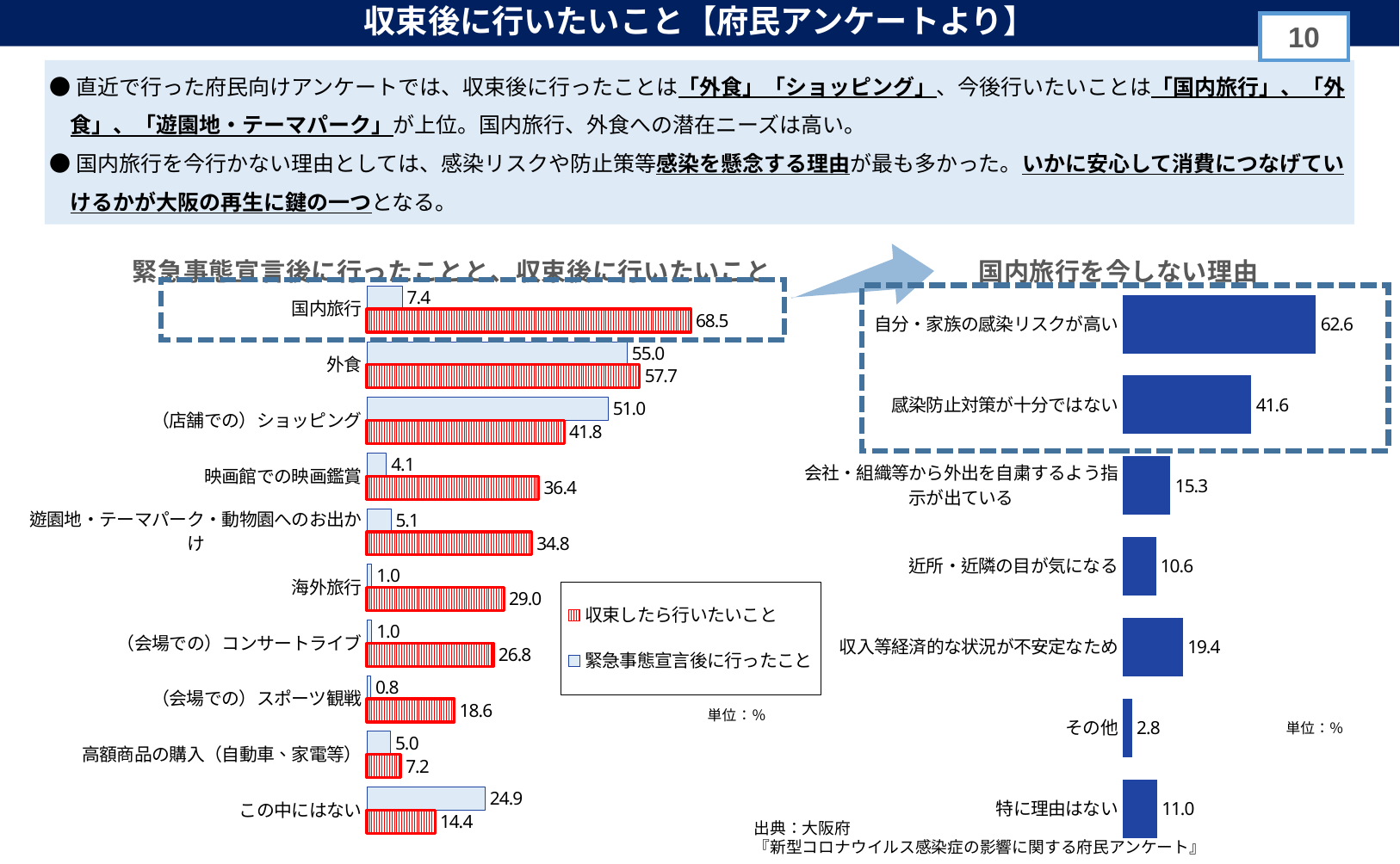
左のグラフ「緊急事態宣言後に行ったことと、収束後に行いたいこと」で、「（店舗での）ショッピング」は「緊急事態宣言後に行ったこと」と「収束したら行いたいこと」のどちらの値が大きいですか？ 緊急事態宣言後に行ったこと 右のグラフ「国内旅行を今しない理由」は、どのような種類のグラフですか？ 棒グラフ 左のグラフ「緊急事態宣言後に行ったことと、収束後に行いたいこと」で、「国内旅行」の「収束したら行いたいこと」と「緊急事態宣言後に行ったこと」の差はいくつですか？ 61.1 右のグラフ「国内旅行を今しない理由」には、いくつの項目がありますか？ 7 左のグラフ「緊急事態宣言後に行ったことと、収束後に行いたいこと」で、「緊急事態宣言後に行ったこと」の値が最も低い項目はどれですか？ （会場での）スポーツ観戦 右のグラフ「国内旅行を今しない理由」で、「感染防止対策が十分ではない」の値はいくつですか？ 41.6 右のグラフ「国内旅行を今しない理由」で、最も値が高い理由はどれですか？ 自分・家族の感染リスクが高い 左のグラフ「緊急事態宣言後に行ったことと、収束後に行いたいこと」で、「国内旅行」の「収束したら行いたいこと」の値はいくつですか？ 68.5 左のグラフ「緊急事態宣言後に行ったことと、収束後に行いたいこと」には、いくつの項目がありますか？ 10 左のグラフ「緊急事態宣言後に行ったことと、収束後に行いたいこと」で、「収束したら行いたいこと」の値が最も高い項目はどれですか？ 国内旅行 左のグラフ「緊急事態宣言後に行ったことと、収束後に行いたいこと」で、「外食」の「緊急事態宣言後に行ったこと」の値はいくつですか？ 55.0 左のグラフ「緊急事態宣言後に行ったことと、収束後に行いたいこと」の凡例には、いくつの系列がありますか？ 2